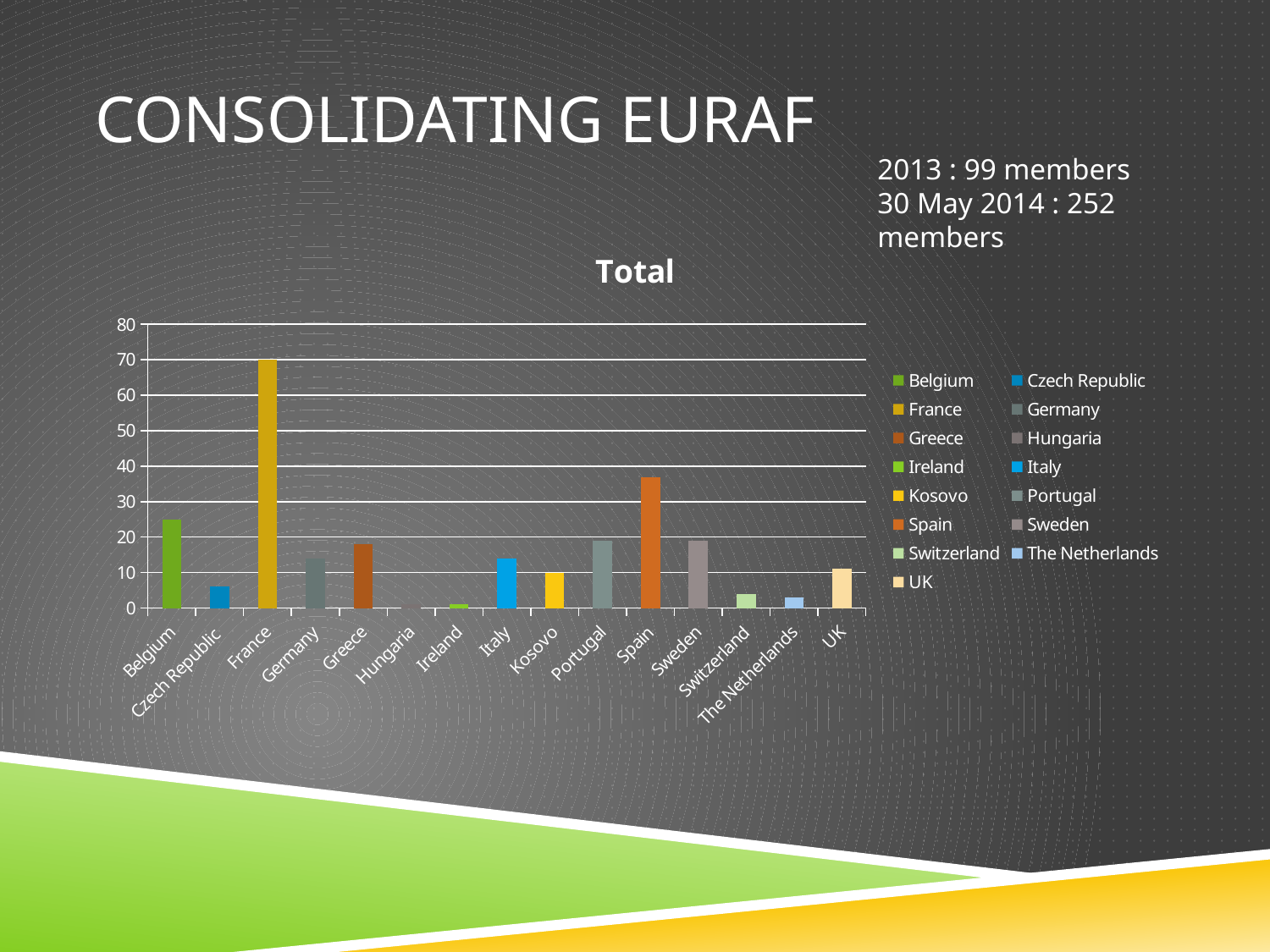
What is the title of the chart? Total How many countries are shown on the x axis of the chart? 15 What kind of chart is shown on the slide? bar chart Which has the larger value, Spain or Belgium? Spain Is the value for Spain greater or less than 30? greater What is the value for France in the chart? 70 Is the value for Germany greater or less than 20? less How many entries does the chart's legend list? 15 Which has the larger value, Belgium or Germany? Belgium Which country has the highest bar in the chart? France Is the value for Czech Republic greater or less than 10? less